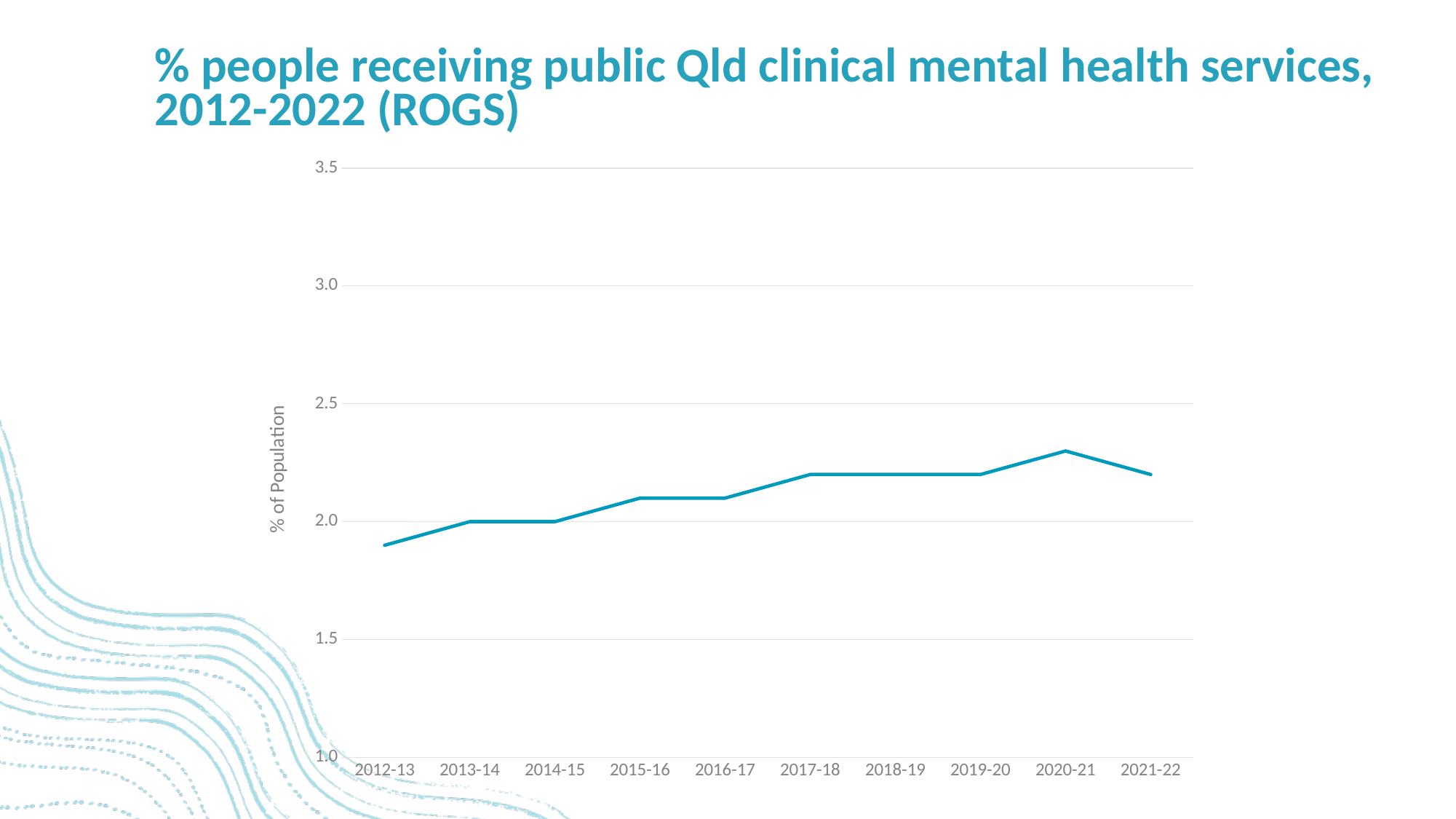
Is the value for 2017-18 greater or less than 2.5? less Is the value for 2020-21 greater or less than 2.0? greater How many financial years are plotted along the x axis? 10 What kind of chart is shown on the slide? line chart What is the value for 2013-14? 2.0 Which year has the lowest % of population receiving public Qld clinical mental health services? 2012-13 Which is larger, the value for 2020-21 or the value for 2012-13? 2020-21 What is the label on the vertical axis? % of Population Does the % of population generally rise or fall from 2012-13 to 2021-22? rise Is the value for 2012-13 greater or less than 2.0? less Which year has the highest % of population receiving public Qld clinical mental health services? 2020-21 What is the value for 2014-15? 2.0